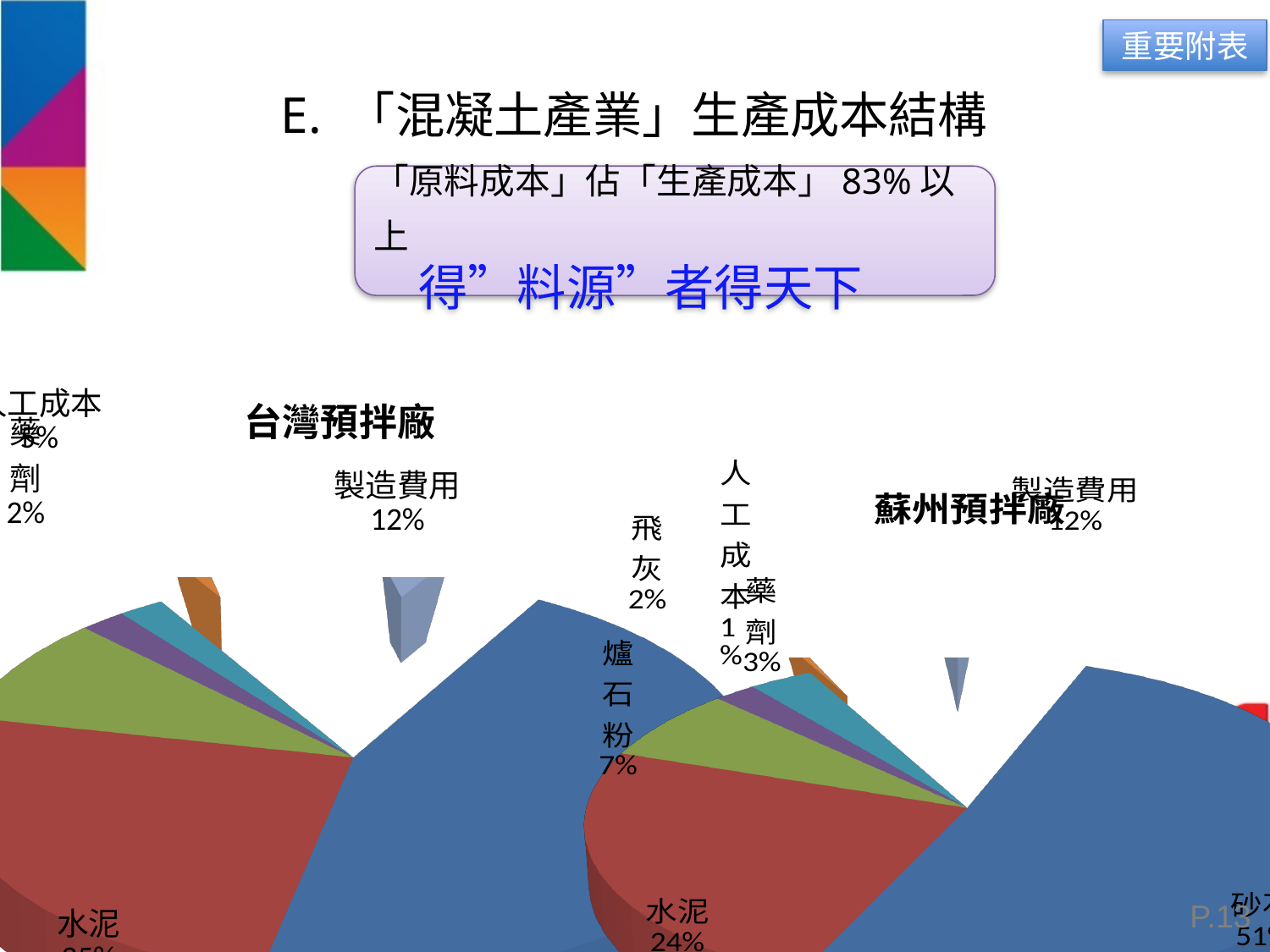
In the 蘇州預拌廠 chart, what share is 製造費用? 12% In the 台灣預拌廠 chart, what share is 製造費用? 12% In the 蘇州預拌廠 chart, what share is 飛灰? 2% In the 台灣預拌廠 chart, what share is 藥劑? 2% In the 蘇州預拌廠 chart, how many percentage points larger is 爐石粉 than 飛灰? 5 percentage points In the 蘇州預拌廠 chart, what share is 藥劑? 3% In the 蘇州預拌廠 chart, which is larger, 水泥 or 製造費用? 水泥 What kind of chart is used for 台灣預拌廠? Pie chart In the 蘇州預拌廠 chart, what share is 爐石粉? 7% How many pie charts are shown on the slide? 2 In the 蘇州預拌廠 chart, what share is 人工成本? 1% In the 蘇州預拌廠 chart, what share is 水泥? 24%